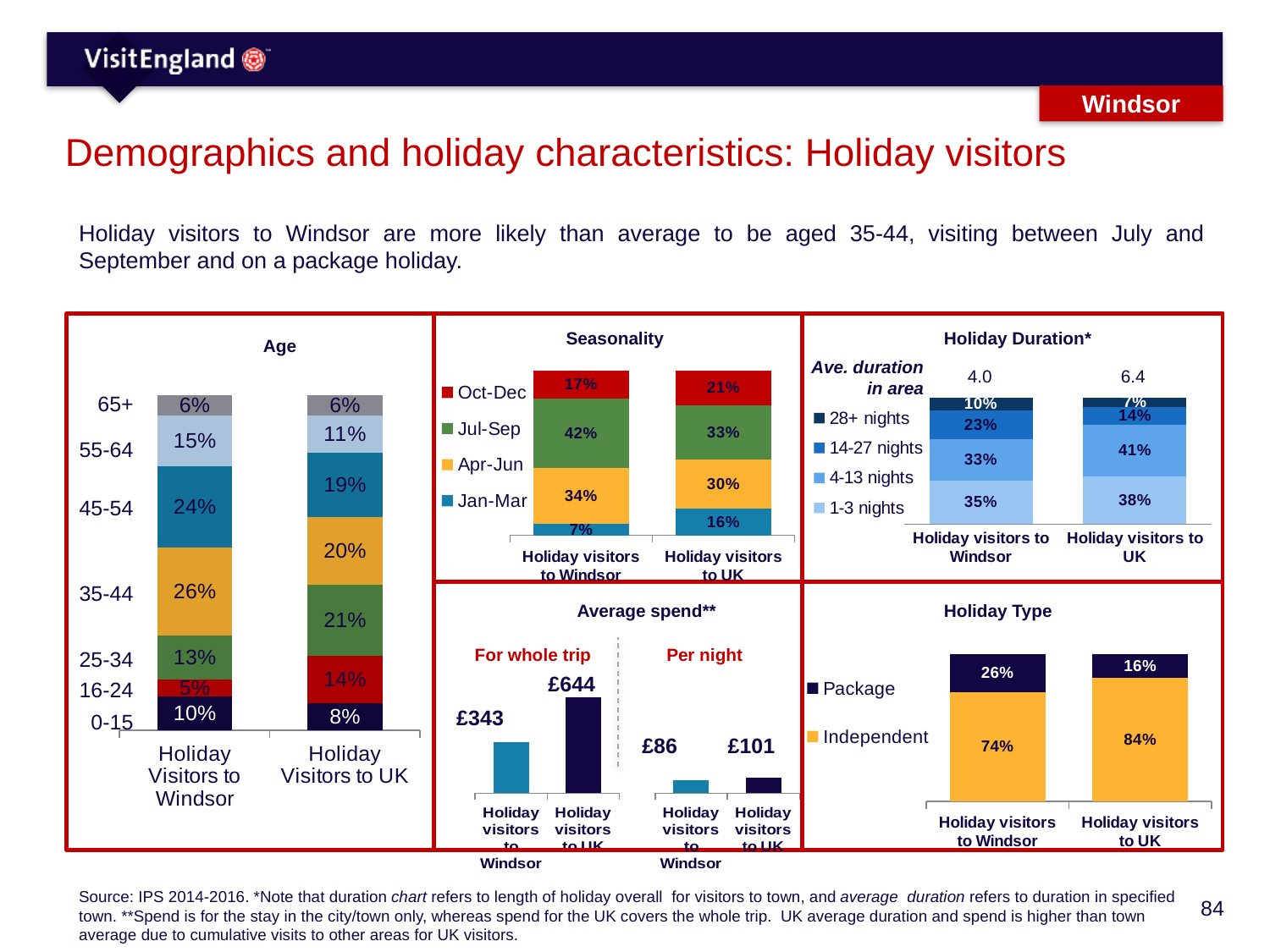
In the Age chart, what is the difference between the 45-54 share for holiday visitors to Windsor and for holiday visitors to UK? 5% In the Holiday Duration chart, what is the average duration in area for holiday visitors to Windsor? 4.0 In the Average spend chart, what is the spend for the whole trip for holiday visitors to UK? £644 In the Age chart, what share of holiday visitors to Windsor are aged 35-44? 26% In the Age chart, which age group is the largest for holiday visitors to UK? 25-34 What kind of chart is the Holiday Type chart? Stacked bar chart How many series does the legend of the Seasonality chart list? 4 In the Holiday Duration chart, what share of holiday visitors to UK stay 4-13 nights? 41% In the Average spend chart, what is the difference in per night spend between holiday visitors to UK and holiday visitors to Windsor? £15 In the Seasonality chart, what percentage of holiday visitors to Windsor visit in Jul-Sep? 42% In the Holiday Type chart, which group has the larger Package share, holiday visitors to Windsor or holiday visitors to UK? Holiday visitors to Windsor In the Seasonality chart, which quarter has the smallest share of holiday visitors to Windsor? Jan-Mar